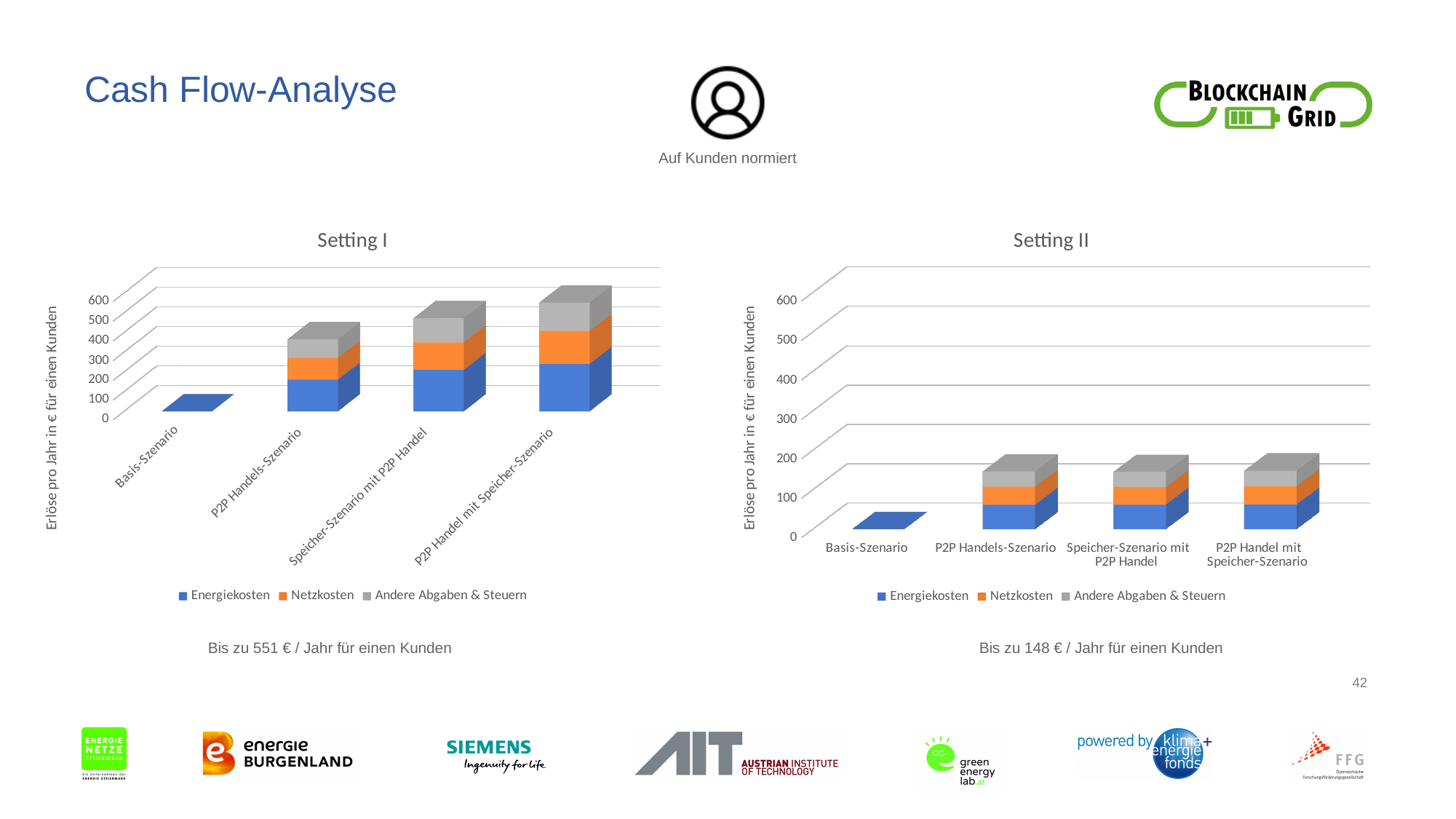
What is the y-axis label of the Setting II chart? Erlöse pro Jahr in € für einen Kunden In the Setting I chart, do the totals rise or fall from left to right along the x axis? rise How many series does the legend of the Setting II chart list? 3 In the Setting I chart, which category has the highest total? P2P Handel mit Speicher-Szenario In the Setting I chart, is the total for P2P Handel mit Speicher-Szenario greater or less than 300? greater How many categories are shown on the x axis of the Setting I chart? 4 In the Setting I chart, which is larger: the total for P2P Handels-Szenario or the total for P2P Handel mit Speicher-Szenario? P2P Handel mit Speicher-Szenario What are the three legend entries of the Setting I chart? Energiekosten, Netzkosten, Andere Abgaben & Steuern In the Setting I chart, which category has the lowest total? Basis-Szenario In the Setting II chart, is the total for P2P Handels-Szenario greater or less than 300? less In the Setting II chart, which category has the lowest total? Basis-Szenario What kind of chart is the Setting I chart? bar chart